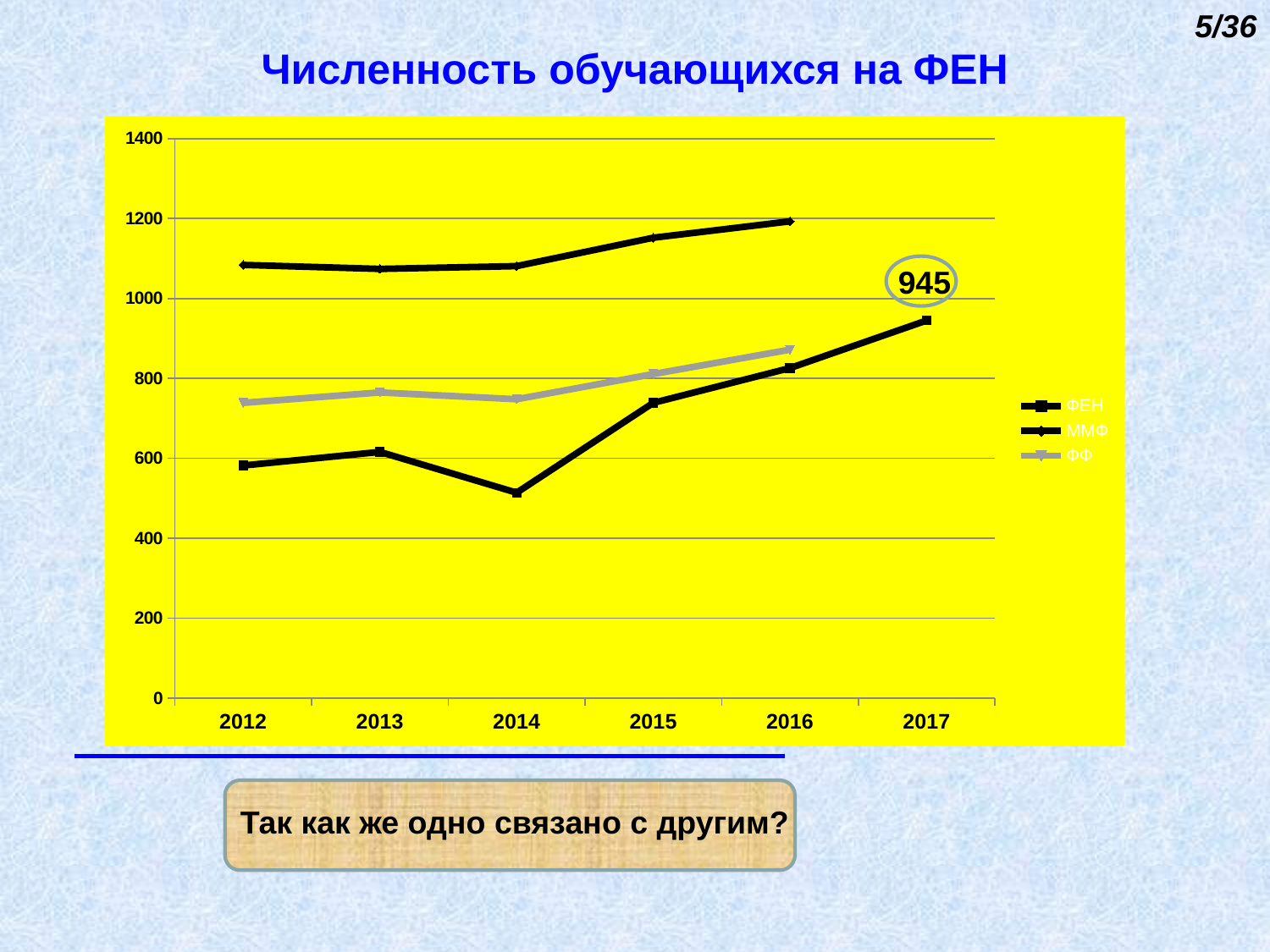
Is the value for ММФ in 2016 greater or less than 1000? greater In 2012, which is larger: ММФ or ФЕН? ММФ How many series does the legend list? 3 What is the title of the chart? Численность обучающихся на ФЕН Does the ФЕН series rise or fall from 2014 to 2017? rise What is the value for ФЕН in 2017? 945 Which series has the highest value in 2015? ММФ Is the value for ФФ in 2012 greater or less than 800? less How many years are shown on the x axis? 6 What kind of chart is shown on the slide? line chart In which year is the ФЕН series at its lowest? 2014 Is the value for ФЕН in 2014 greater or less than 600? less